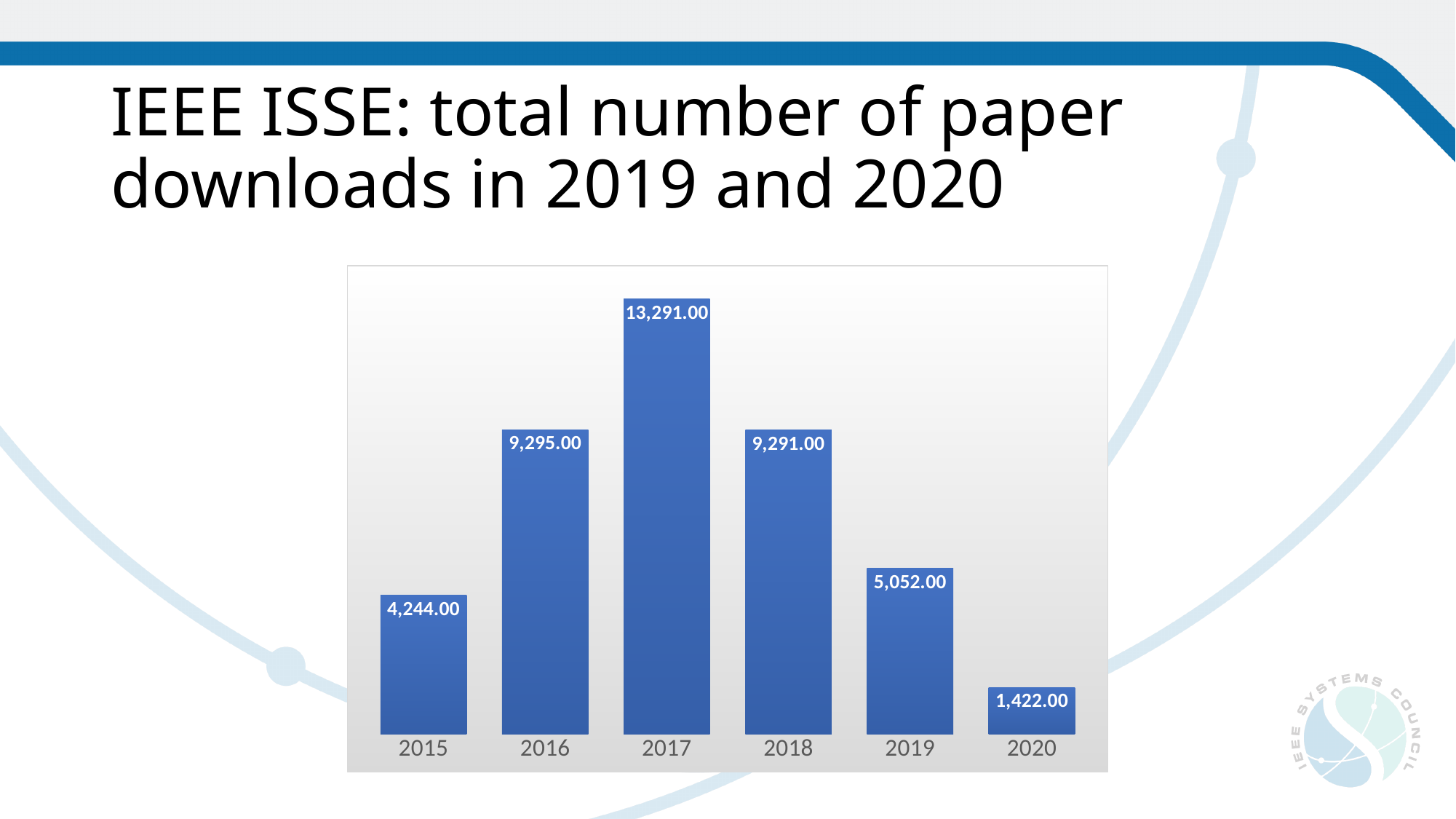
What is the value for 2017? 13,291.00 What is the value for 2020? 1,422.00 Which year has the highest value? 2017 What is the difference between the values for 2019 and 2020? 3,630.00 What is the difference between the values for 2017 and 2018? 4,000.00 What kind of chart is shown on the slide? bar chart Which year has the lowest value? 2020 How many years are shown on the x axis? 6 Do the values rise or fall from 2017 to 2020? fall Which is larger, the value for 2015 or the value for 2019? 2019 What is the value for 2015? 4,244.00 What is the value for 2019? 5,052.00